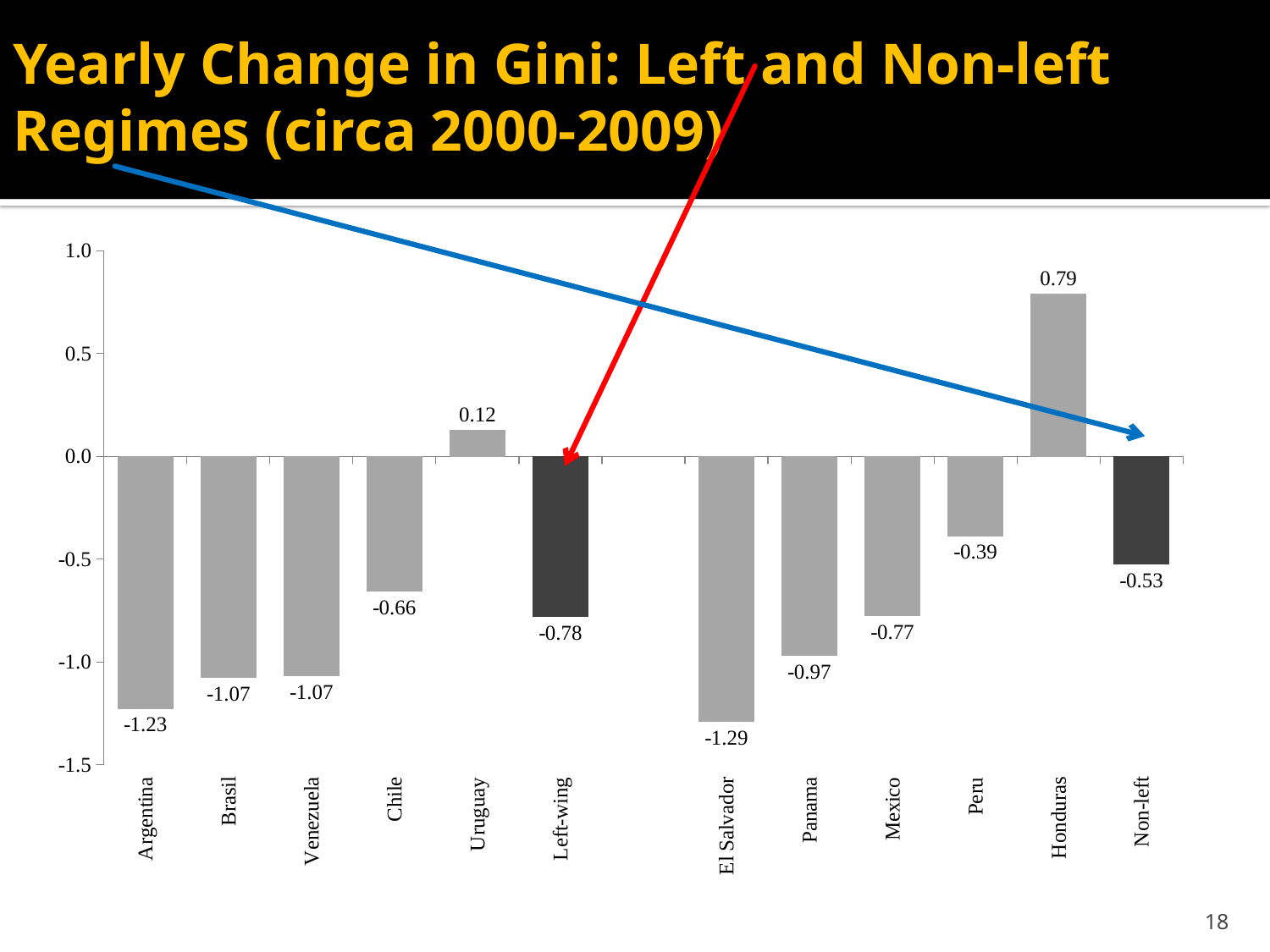
Which category has the highest value? Honduras What is the difference between the Honduras value and the Uruguay value? 0.67 What is the yearly change in Gini for Argentina? -1.23 Which is larger, the value for Peru or the value for Mexico? Peru Which category has the lowest value? El Salvador What is the value shown for the Non-left bar? -0.53 What kind of chart is shown on the slide? Bar chart What is the title of the slide? Yearly Change in Gini: Left and Non-left Regimes (circa 2000-2009) What is the value shown for Honduras? 0.79 Is the value for Panama greater or less than -0.5? less What is the value shown for the Left-wing bar? -0.78 How many bars are plotted in the chart? 12